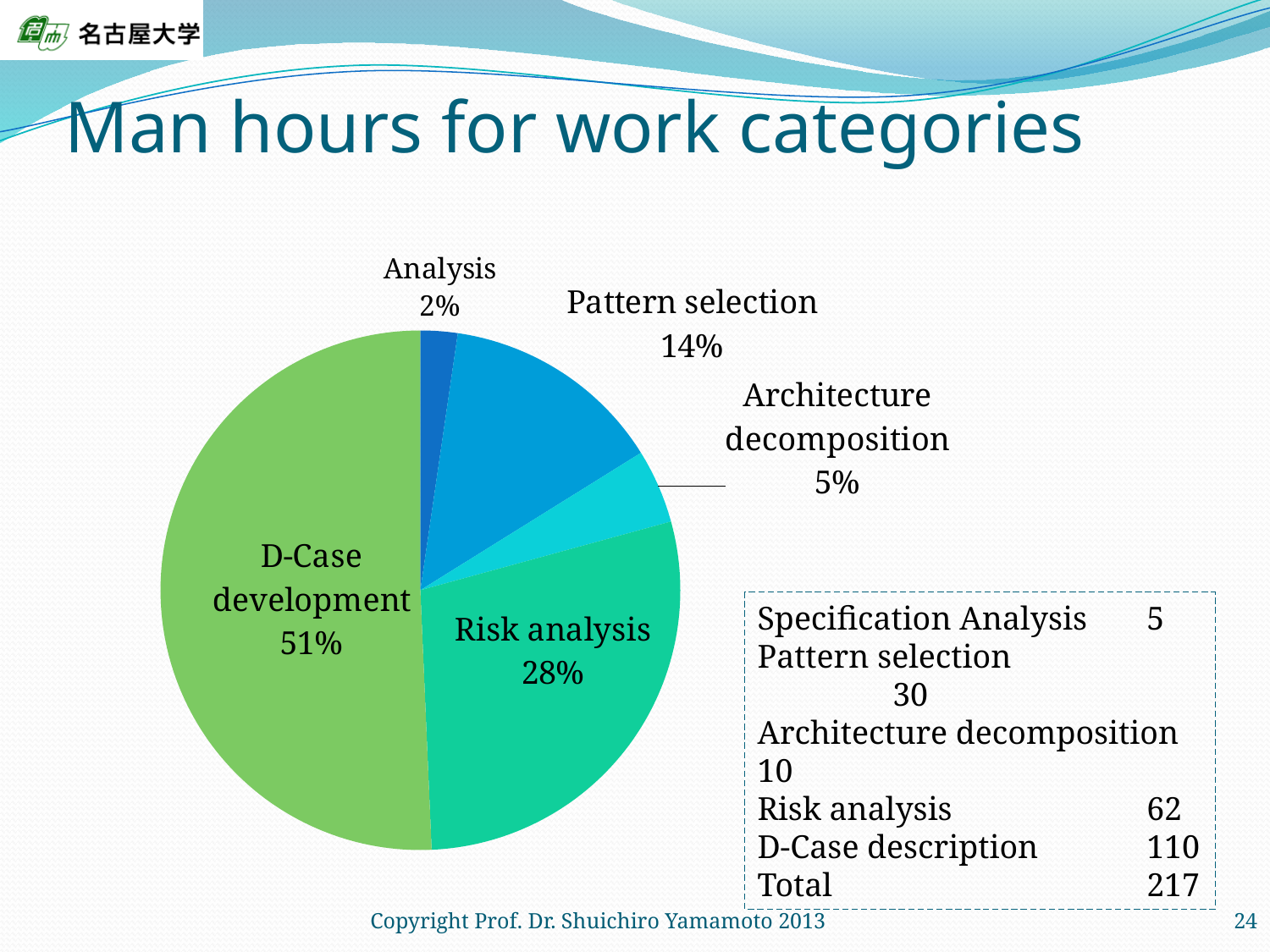
What is the difference in percentage points between D-Case development and Risk analysis? 23 What is the title of the slide containing the pie chart? Man hours for work categories Which slice is larger, Pattern selection or Architecture decomposition? Pattern selection What percentage is shown for Architecture decomposition? 5% Which category has the smallest slice of the pie? Analysis What percentage is shown for Analysis? 2% What kind of chart is shown on the slide? pie chart How many slices does the pie chart have? 5 What share of the pie does Risk analysis represent? 28% What percentage is shown for Pattern selection? 14% Which category has the largest slice of the pie? D-Case development What share of the pie does D-Case development represent? 51%